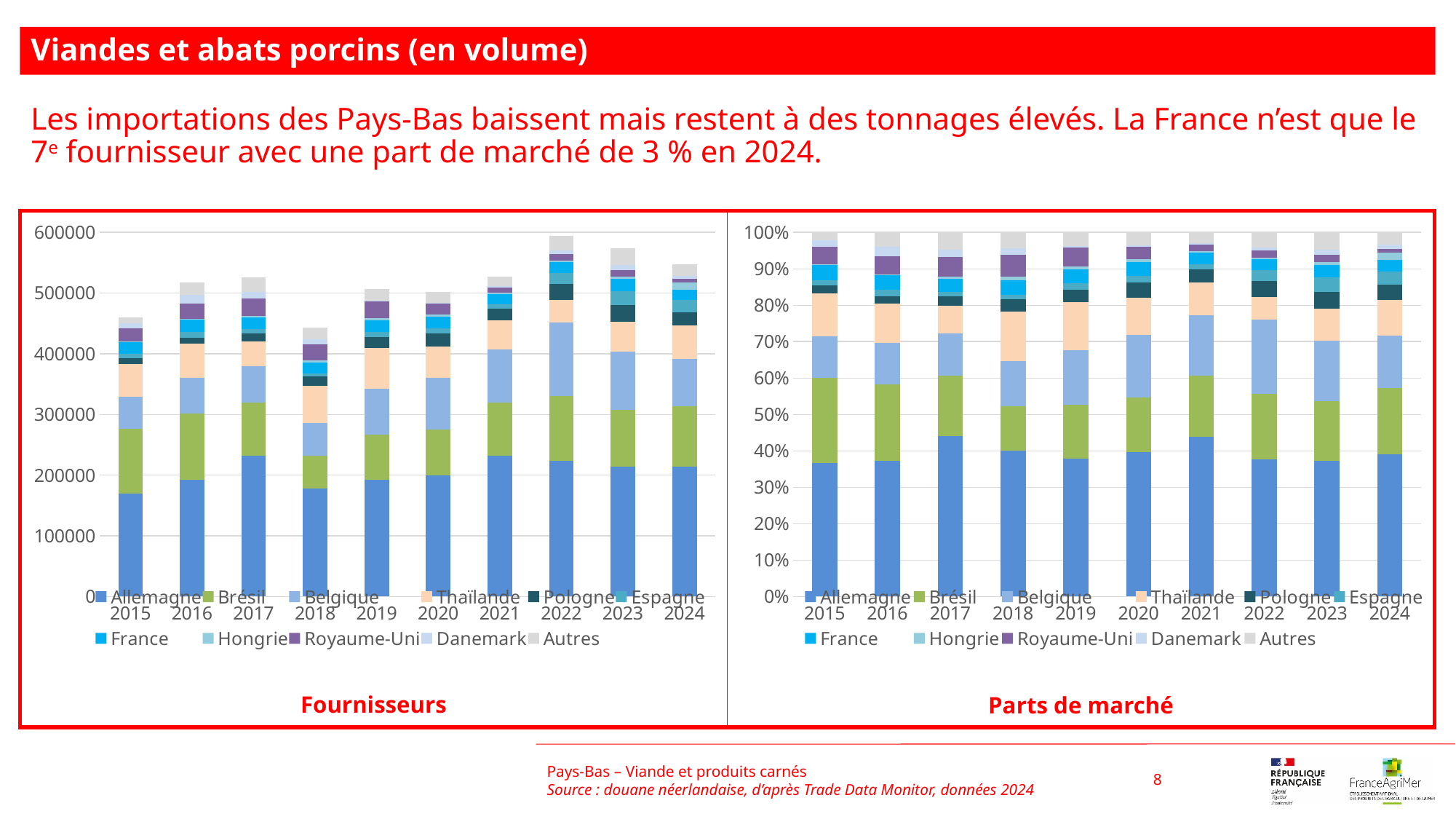
In the 'Fournisseurs' chart, is the value for Allemagne in 2017 greater or less than 200000? greater In the 'Fournisseurs' chart, which year has the highest total bar? 2022 In the 'Parts de marché' chart, is the share for Allemagne in 2016 greater or less than 40%? less In the 'Fournisseurs' chart, is the total for 2018 greater or less than 500000? less What is the title of the chart on the right side of the slide? Parts de marché How many series does the legend of the 'Parts de marché' chart list? 11 In the 'Fournisseurs' chart, which total bar is larger, 2022 or 2018? 2022 In the 'Fournisseurs' chart, which year has the lowest total bar? 2018 How many years are shown on the x axis of the 'Fournisseurs' chart? 10 What kind of chart is the 'Fournisseurs' chart on the left? stacked bar chart